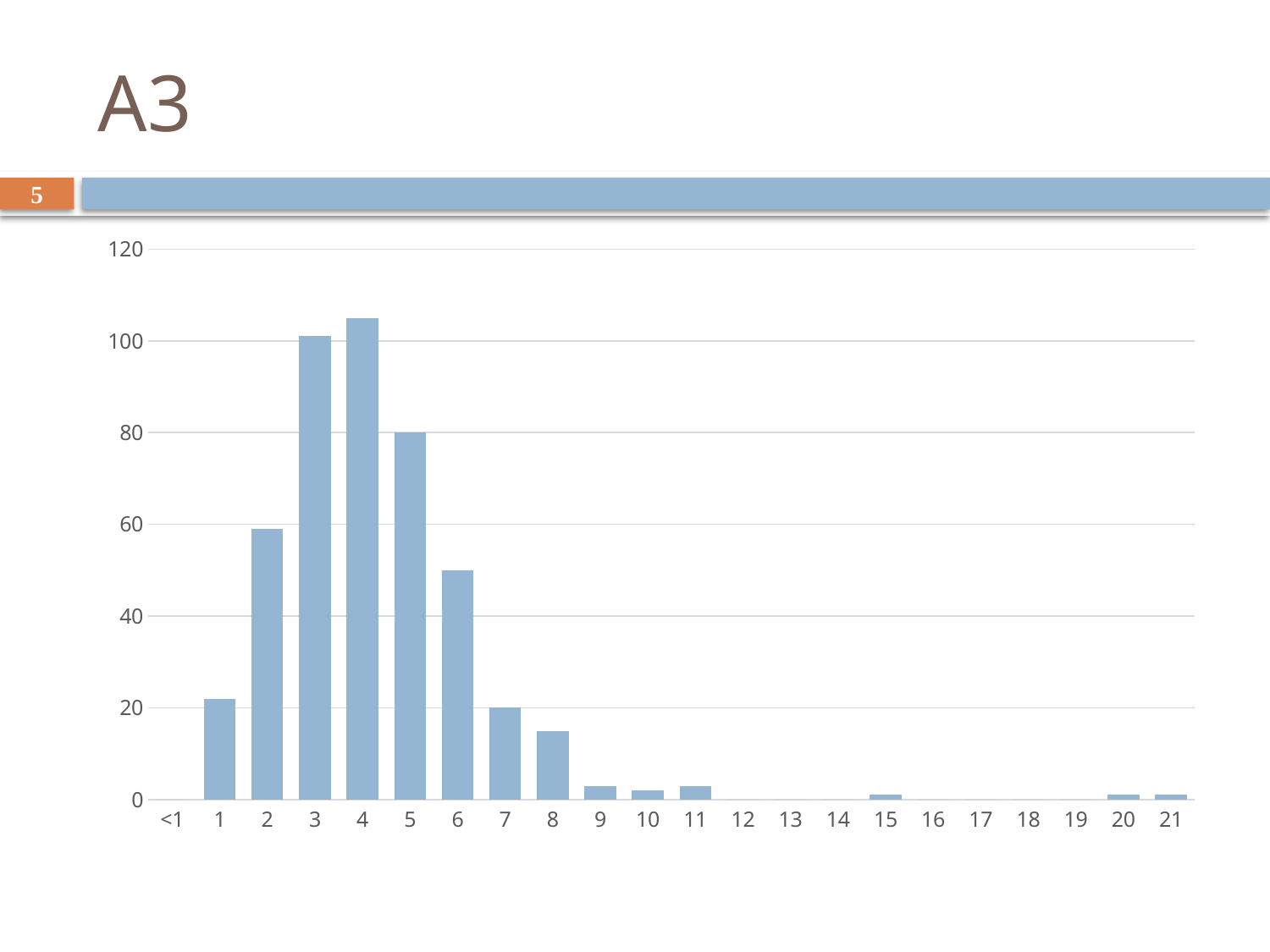
Which category has the tallest bar? 4 What is the title of the slide? A3 What is the value for category 5? 80 What is the value for category 7? 20 Which is larger, the value for category 2 or the value for category 5? 5 Do the values rise or fall from category 4 to category 8? fall What kind of chart is shown on the slide? bar chart Is the value for category 8 greater or less than 20? less Is the value for category 2 greater or less than 40? greater How many categories are shown on the x axis? 22 Is the value for category 1 greater or less than 40? less